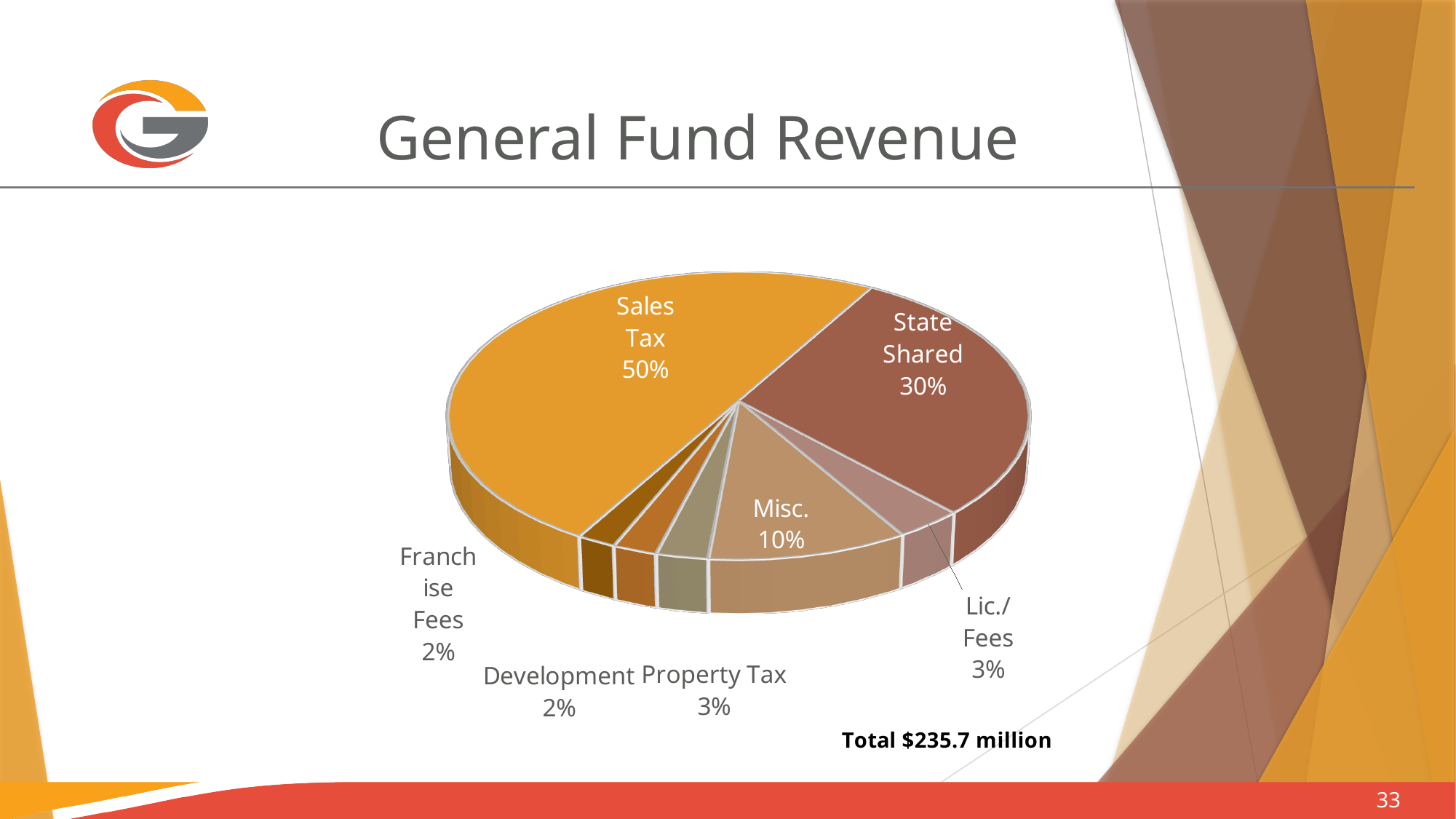
What is the difference in percentage points between Sales Tax and State Shared? 20 Which is larger, the Misc. share or the Property Tax share? Misc. What kind of chart is shown on the slide? pie chart What is the total General Fund Revenue stated on the slide? $235.7 million What percentage of General Fund Revenue comes from Franchise Fees? 2% What is the title of the chart on the slide? General Fund Revenue What share of General Fund Revenue is State Shared? 30% Which revenue source has the largest share of the pie? Sales Tax What share of General Fund Revenue comes from Sales Tax? 50% What percentage of General Fund Revenue comes from Lic./Fees? 3% How many slices does the pie chart have? 7 What percentage of General Fund Revenue is Misc.? 10%